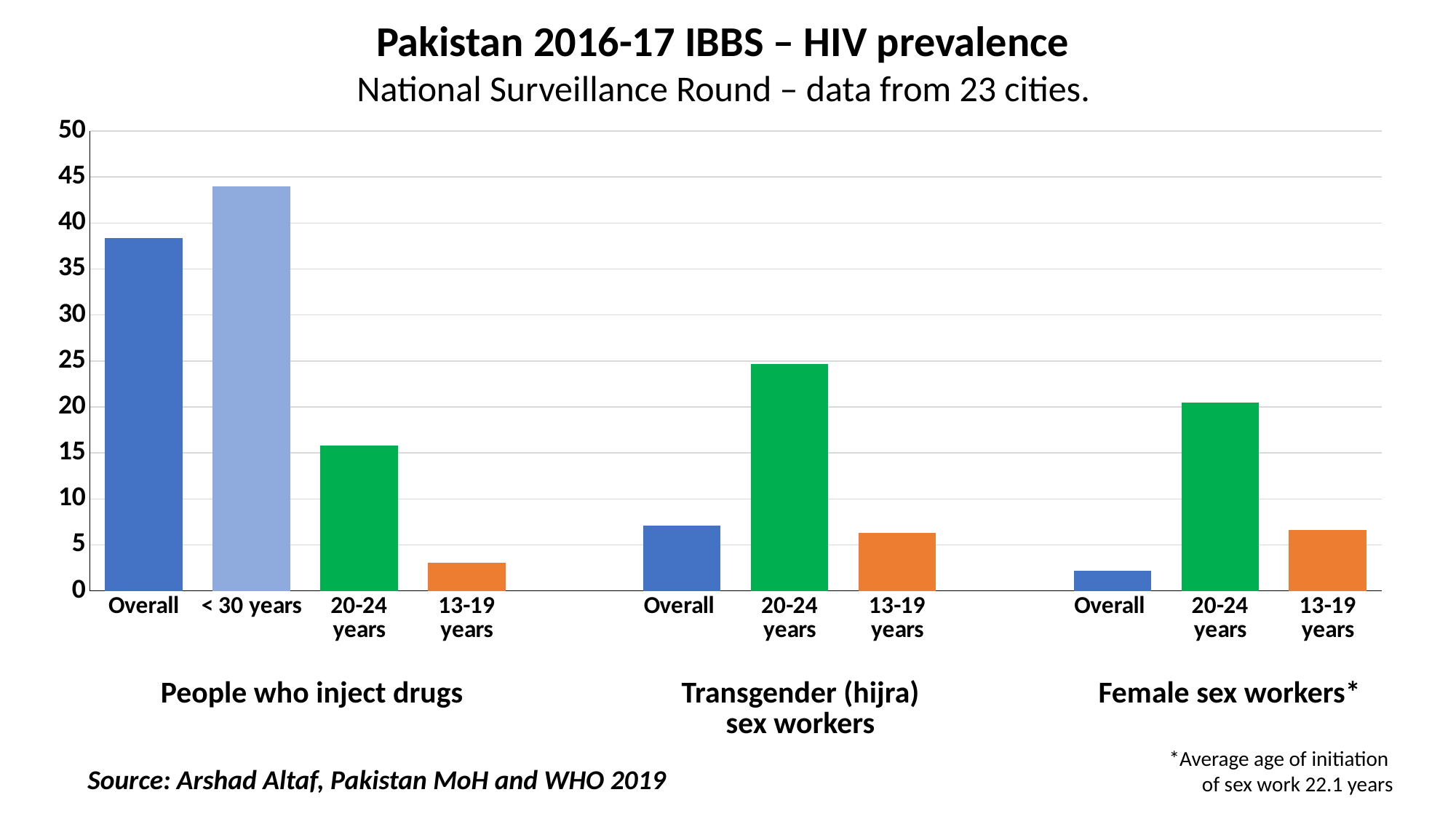
How many population groups are shown along the x axis? 3 Which bar has the lowest HIV prevalence in the chart? Overall (Female sex workers) Is the 'Overall' value for people who inject drugs greater or less than 35? greater Which is larger: the '20-24 years' value for people who inject drugs or the '20-24 years' value for transgender (hijra) sex workers? Transgender (hijra) sex workers Which bar has the highest HIV prevalence in the chart? < 30 years (People who inject drugs) What kind of chart is shown on the slide? bar chart Is the value for '13-19 years' among people who inject drugs greater or less than 5? less Is the value for '20-24 years' among transgender (hijra) sex workers greater or less than 20? greater What is the title of the chart? Pakistan 2016-17 IBBS – HIV prevalence How many bars are plotted in the chart? 11 Which is larger: the 'Overall' value for people who inject drugs or the 'Overall' value for transgender (hijra) sex workers? People who inject drugs